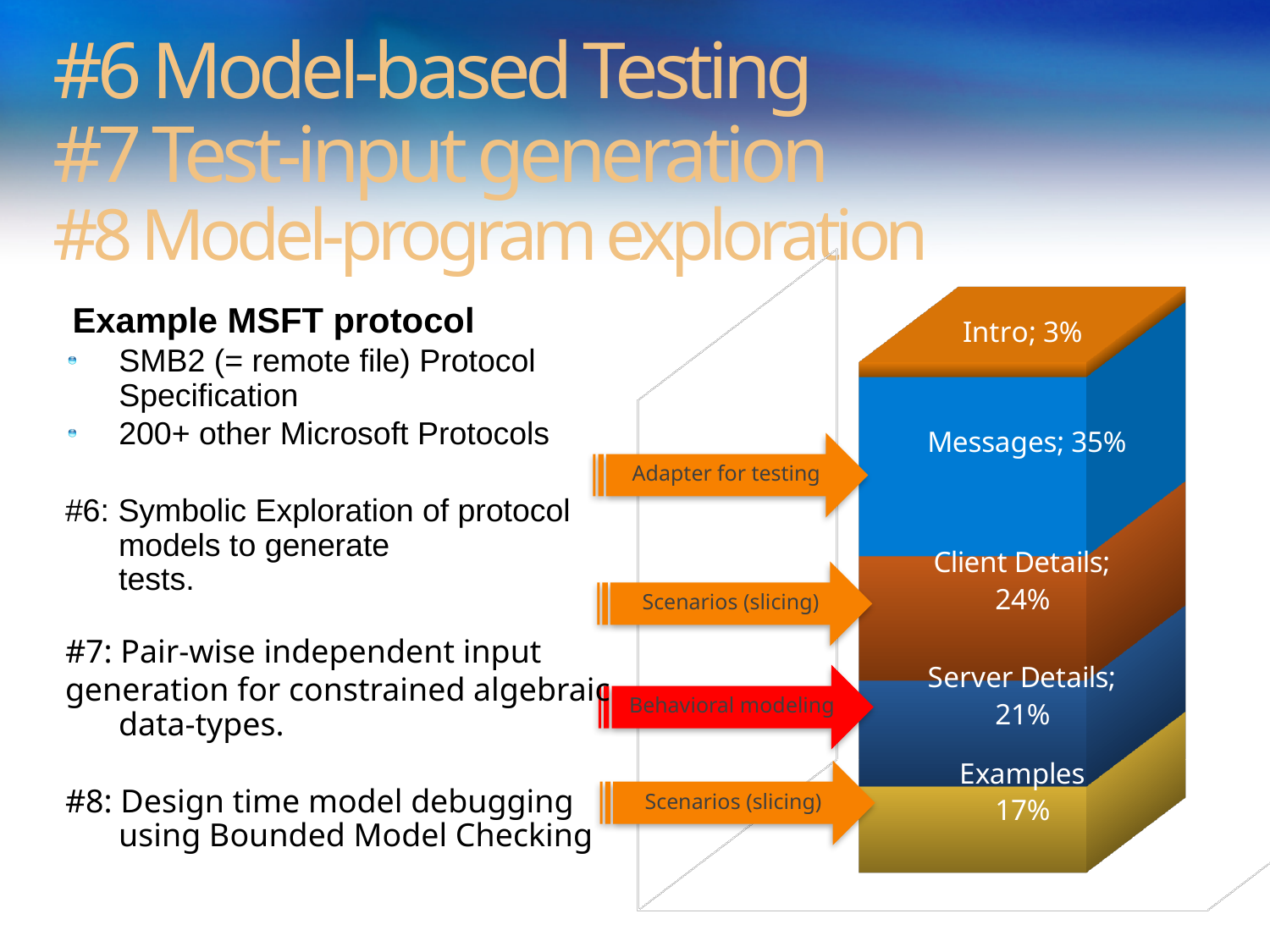
What kind of chart is shown on the slide? Stacked bar chart What percentage is shown for the Client Details segment? 24% Which is larger, the Server Details segment or the Examples segment? Server Details Which segment of the stacked bar has the smallest percentage? Intro How many segments make up the stacked bar? 5 What percentage is shown for the Examples segment? 17% What percentage is shown for the Intro segment? 3% What percentage is shown for the Server Details segment? 21% What is the difference between the Messages and Client Details percentages? 11% What is the total of all the segments in the stacked bar? 100% What percentage is shown for the Messages segment of the stacked bar? 35% Which segment of the stacked bar has the largest percentage? Messages